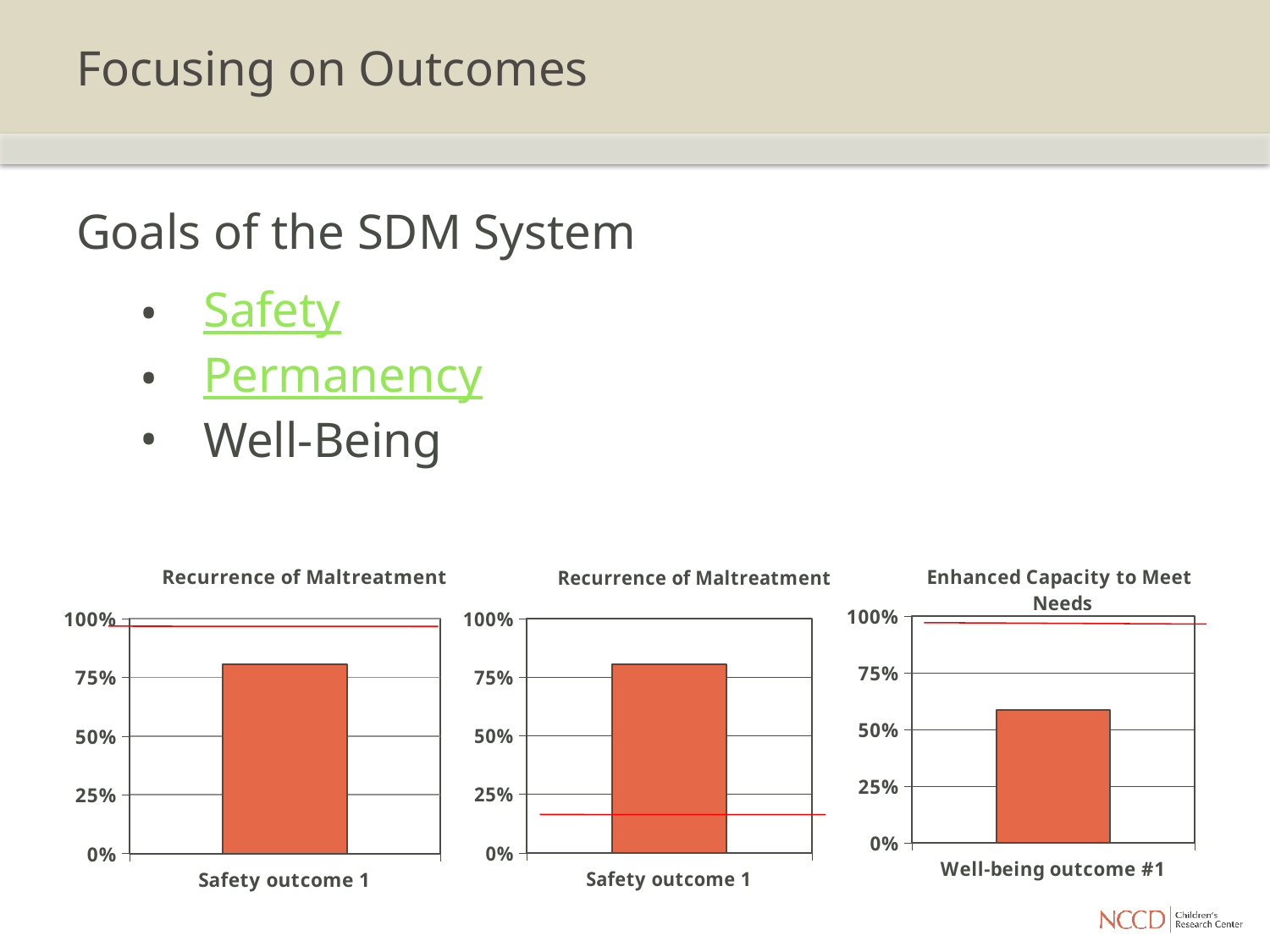
How many bars are plotted in the left chart titled "Recurrence of Maltreatment"? 1 In the left chart, is the value for Safety outcome 1 greater or less than 100%? less What is the title of the right chart on the slide? Enhanced Capacity to Meet Needs How many bars are plotted in the right chart titled "Enhanced Capacity to Meet Needs"? 1 In the middle chart, is the value for Safety outcome 1 greater or less than 50%? greater In the right chart titled "Enhanced Capacity to Meet Needs", is the value for Well-being outcome #1 greater or less than 50%? greater How many charts are shown on the slide? 3 What is the category label on the x axis of the right chart? Well-being outcome #1 What type of chart is the right chart titled "Enhanced Capacity to Meet Needs"? bar chart What type of chart is the left chart titled "Recurrence of Maltreatment"? bar chart